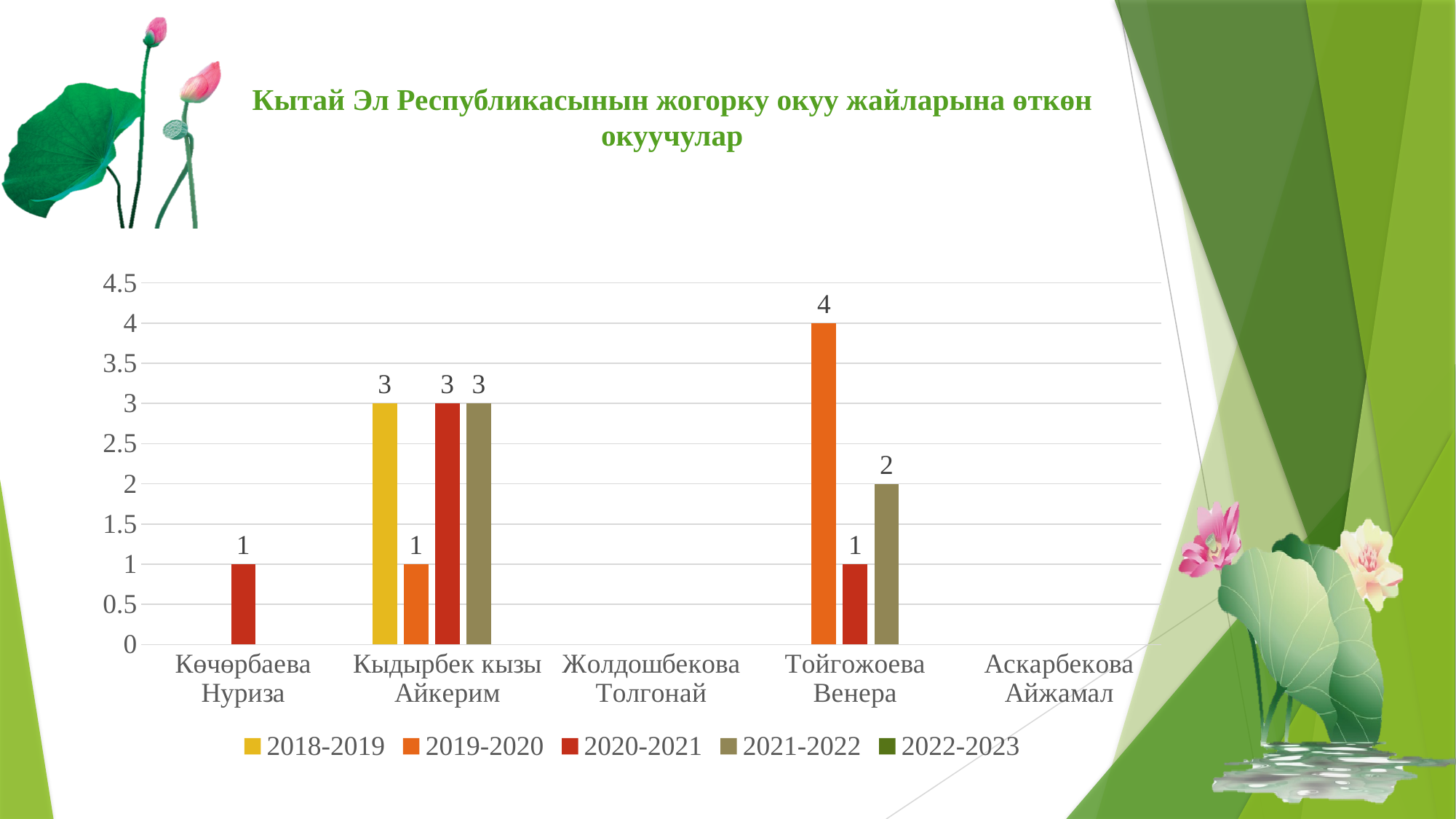
What is the title of the chart? Кытай Эл Республикасынын жогорку окуу жайларына өткөн окуучулар What is the value for Көчөрбаева Нуриза in the 2020-2021 series? 1 What is the value for Кыдырбек кызы Айкерим in the 2018-2019 series? 3 How many categories are shown on the x axis? 5 What is the difference between the 2019-2020 values for Тойгожоева Венера and Кыдырбек кызы Айкерим? 3 Which is larger: the 2021-2022 value for Кыдырбек кызы Айкерим or the 2021-2022 value for Тойгожоева Венера? Кыдырбек кызы Айкерим What is the value for Тойгожоева Венера in the 2019-2020 series? 4 How many series does the legend list? 5 What is the value for Тойгожоева Венера in the 2021-2022 series? 2 Which category has the highest single bar on the chart? Тойгожоева Венера Which series is shown in orange in the legend? 2019-2020 What kind of chart is shown on the slide? bar chart